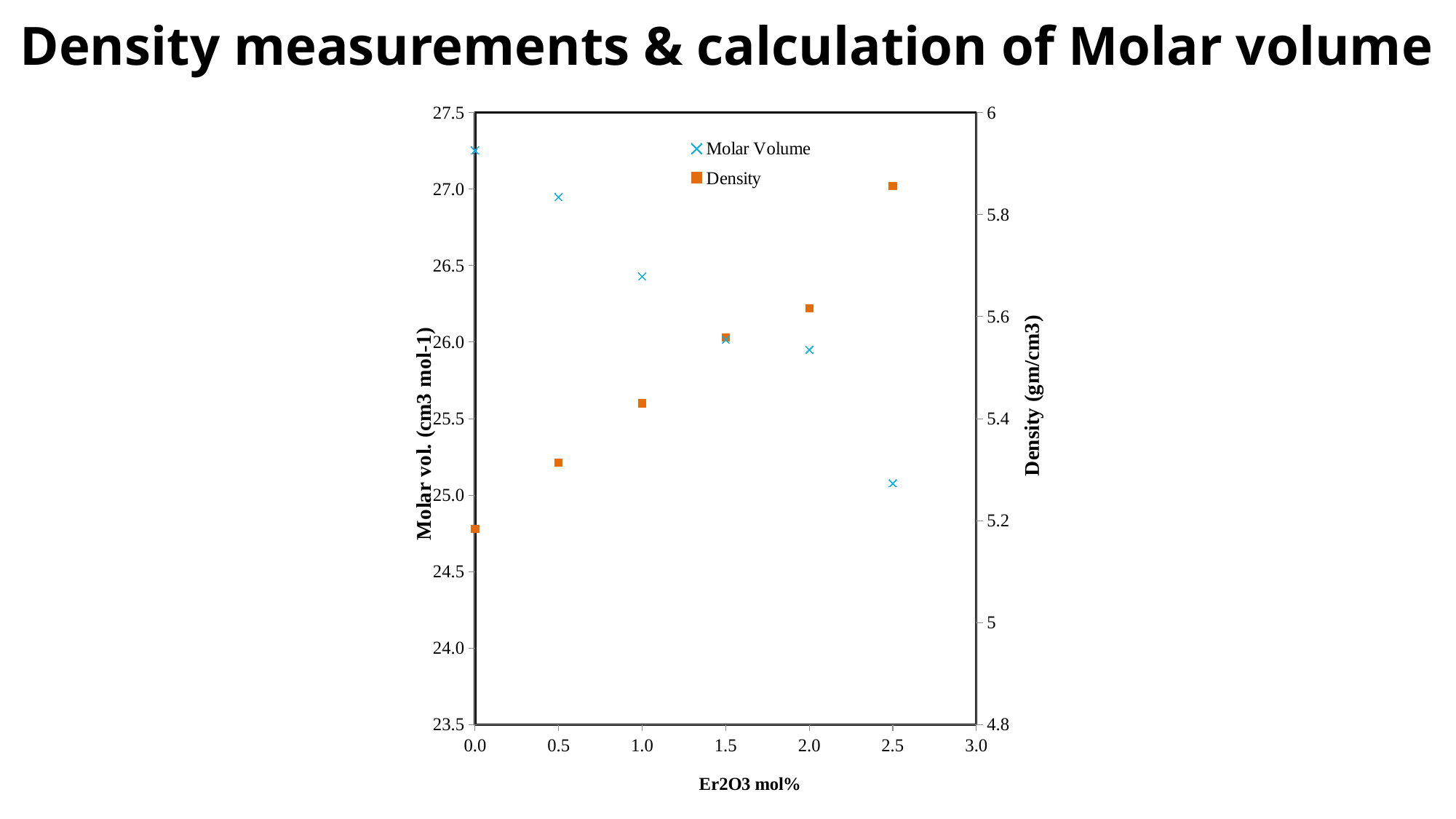
Does the Molar Volume series rise or fall as Er2O3 mol% increases? Falls Does the Density series rise or fall as Er2O3 mol% increases? Rises At which Er2O3 mol% is the Density lowest? 0.0 Which is larger, the Molar Volume at 0.5 Er2O3 mol% or at 2.0 Er2O3 mol%? 0.5 Er2O3 mol% What kind of chart is shown on the slide? Scatter chart How many data points are plotted for the Molar Volume series? 6 Is the Density at 2.5 Er2O3 mol% greater or less than 5.8? greater At which Er2O3 mol% is the Molar Volume highest? 0.0 How many series does the legend list? 2 Is the Molar Volume at 0.0 Er2O3 mol% greater or less than 27.0? greater What is the label of the x axis? Er2O3 mol% Is the Molar Volume at 2.5 Er2O3 mol% greater or less than 25.5? less